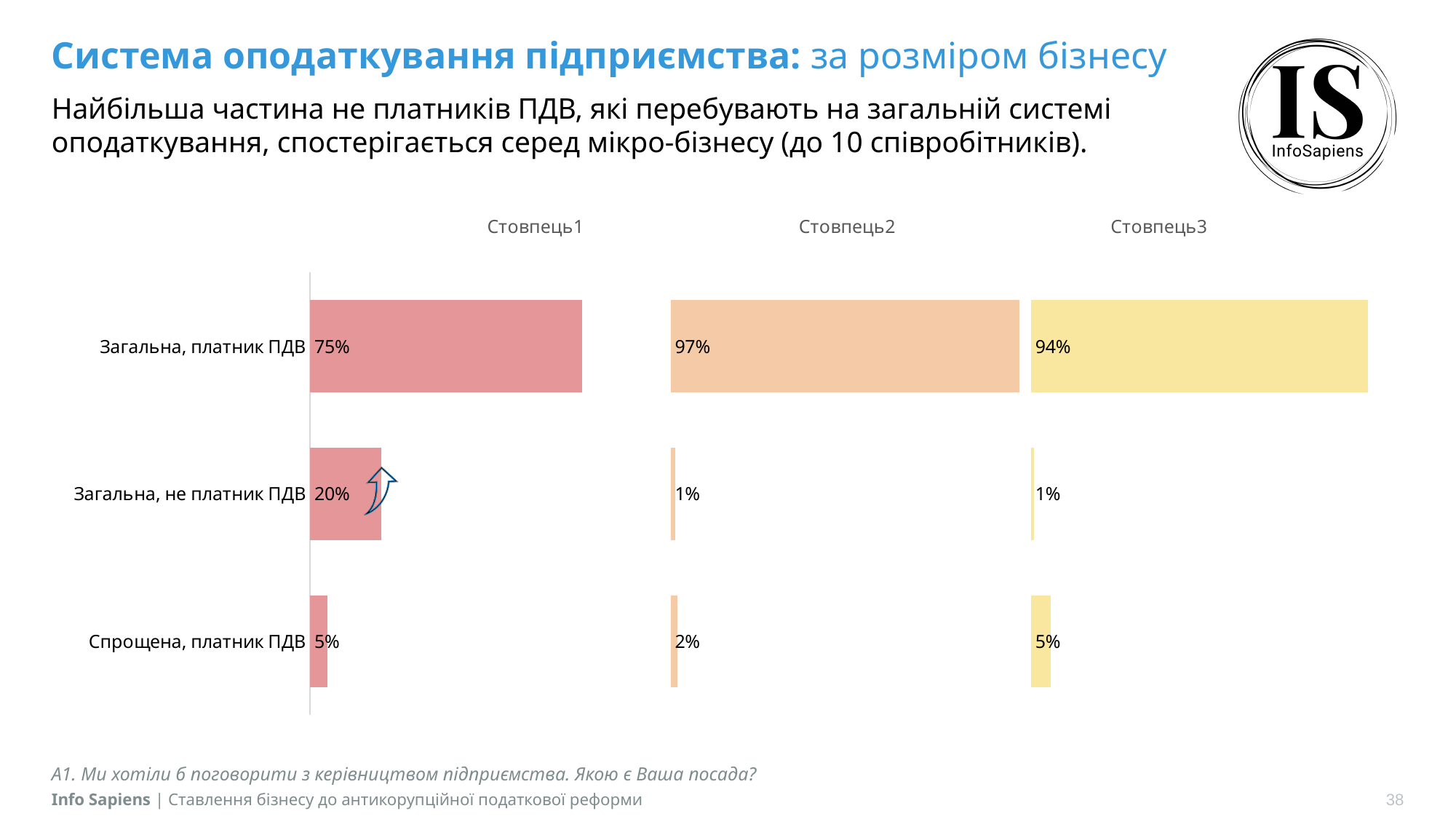
Which category has the lowest value in the Стовпець1 series? Спрощена, платник ПДВ What is the value for "Загальна, платник ПДВ" in the Стовпець2 series? 97% Which category has the highest value in the Стовпець3 series? Загальна, платник ПДВ What is the value for "Спрощена, платник ПДВ" in the Стовпець3 series? 5% What is the value for "Загальна, не платник ПДВ" in the Стовпець2 series? 1% What kind of chart is shown on the slide? Bar chart What is the difference between the Стовпець2 and Стовпець1 values for "Загальна, платник ПДВ"? 22% Which is larger for "Загальна, не платник ПДВ": the Стовпець1 value or the Стовпець3 value? Стовпець1 How many series does the chart show? 3 What is the difference between the Стовпець3 and Стовпець2 values for "Спрощена, платник ПДВ"? 3% How many categories are shown on the chart? 3 What is the value for "Загальна, платник ПДВ" in the Стовпець1 series? 75%